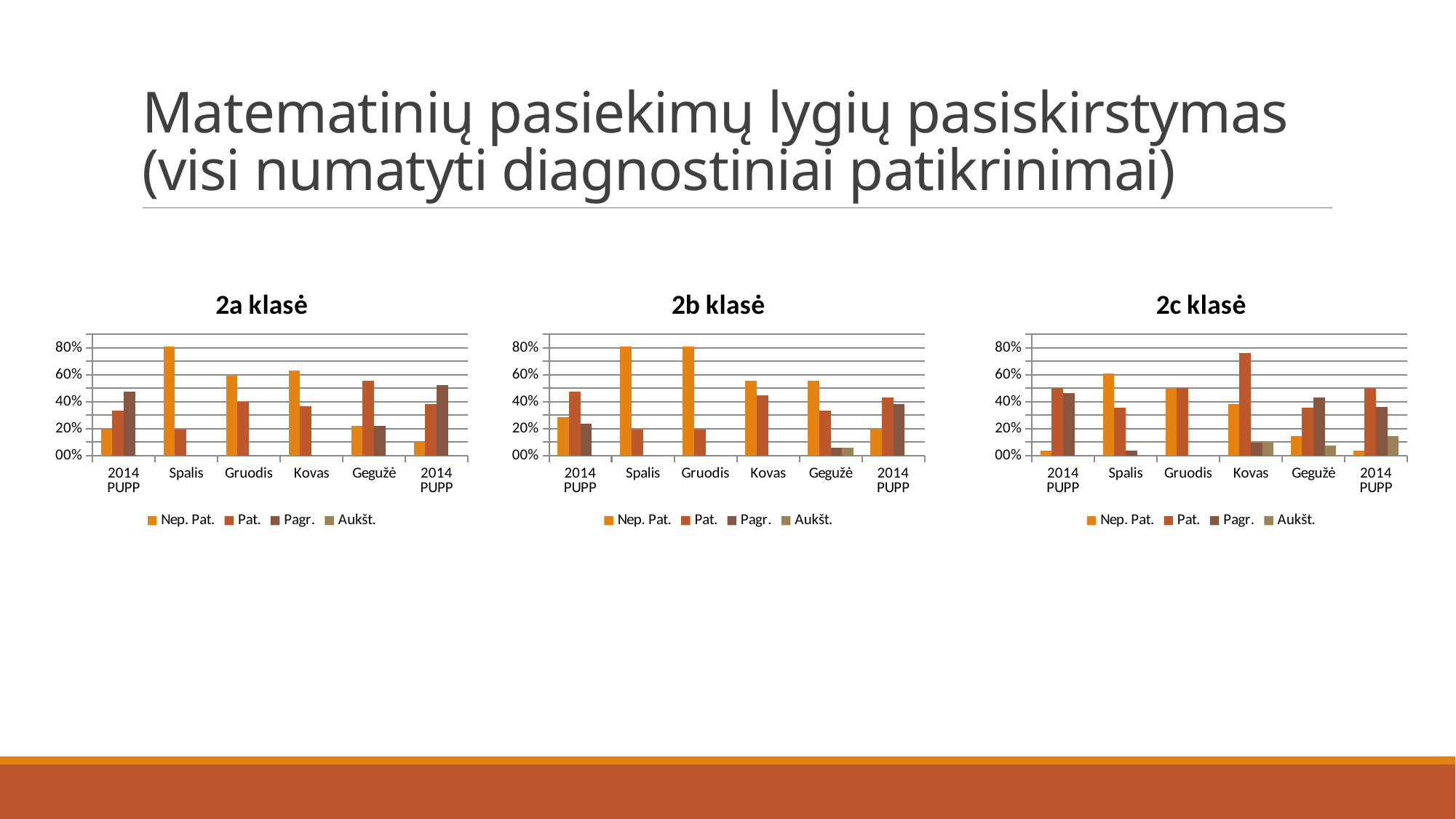
In the "2a klasė" chart, which category has the highest Nep. Pat. value? Spalis In the "2b klasė" chart, is the Nep. Pat. value for Kovas greater or less than 40%? greater In the "2c klasė" chart, is the Pat. value for Kovas greater or less than 60%? greater In the "2c klasė" chart, is the Nep. Pat. value for the first 2014 PUPP category greater or less than 20%? less What are the legend entries of the "2c klasė" chart? Nep. Pat., Pat., Pagr., Aukšt. How many categories are shown on the x axis of the "2a klasė" chart? 6 How many series does the legend of the "2b klasė" chart list? 4 What kind of chart is the "2a klasė" chart? bar chart In the "2c klasė" chart, which category has the highest Pat. value? Kovas In the "2a klasė" chart, for Gegužė, which is larger: Nep. Pat. or Pat.? Pat.